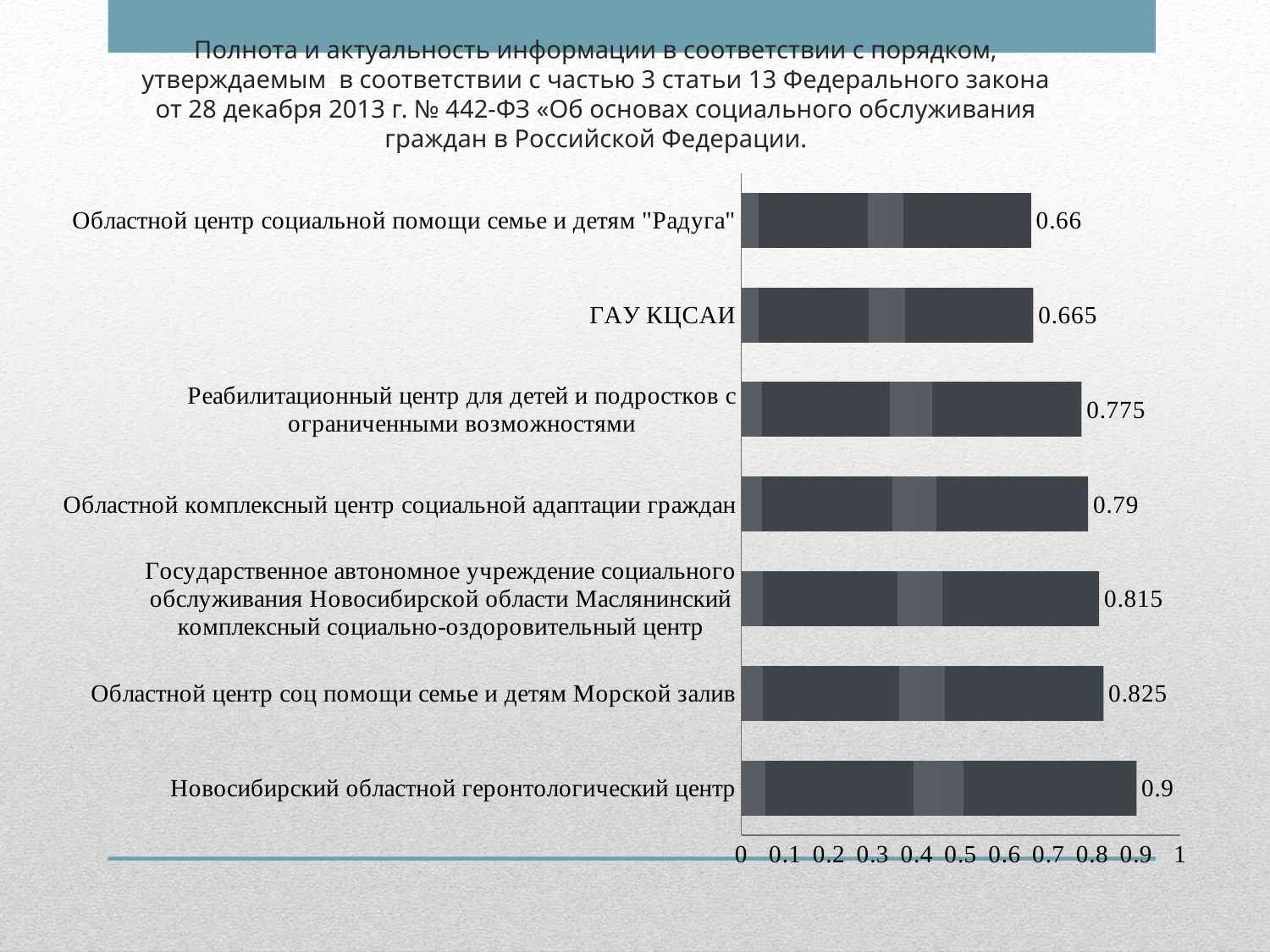
What is the value for Новосибирский областной геронтологический центр? 0.9 What kind of chart is shown on the slide? bar chart Which organisation has the highest value? Новосибирский областной геронтологический центр What is the value for Реабилитационный центр для детей и подростков с ограниченными возможностями? 0.775 What is the difference between the values for Новосибирский областной геронтологический центр and Областной центр социальной помощи семье и детям "Радуга"? 0.24 What is the value for Областной центр соц помощи семье и детям Морской залив? 0.825 What is the maximum value shown on the horizontal axis? 1 Which organisation has the lowest value? Областной центр социальной помощи семье и детям "Радуга" How many organisations are shown in the chart? 7 What is the value for ГАУ КЦСАИ? 0.665 Is the value for Областной центр социальной помощи семье и детям "Радуга" greater or less than 0.7? less Which has a larger value: Областной комплексный центр социальной адаптации граждан or ГАУ КЦСАИ? Областной комплексный центр социальной адаптации граждан